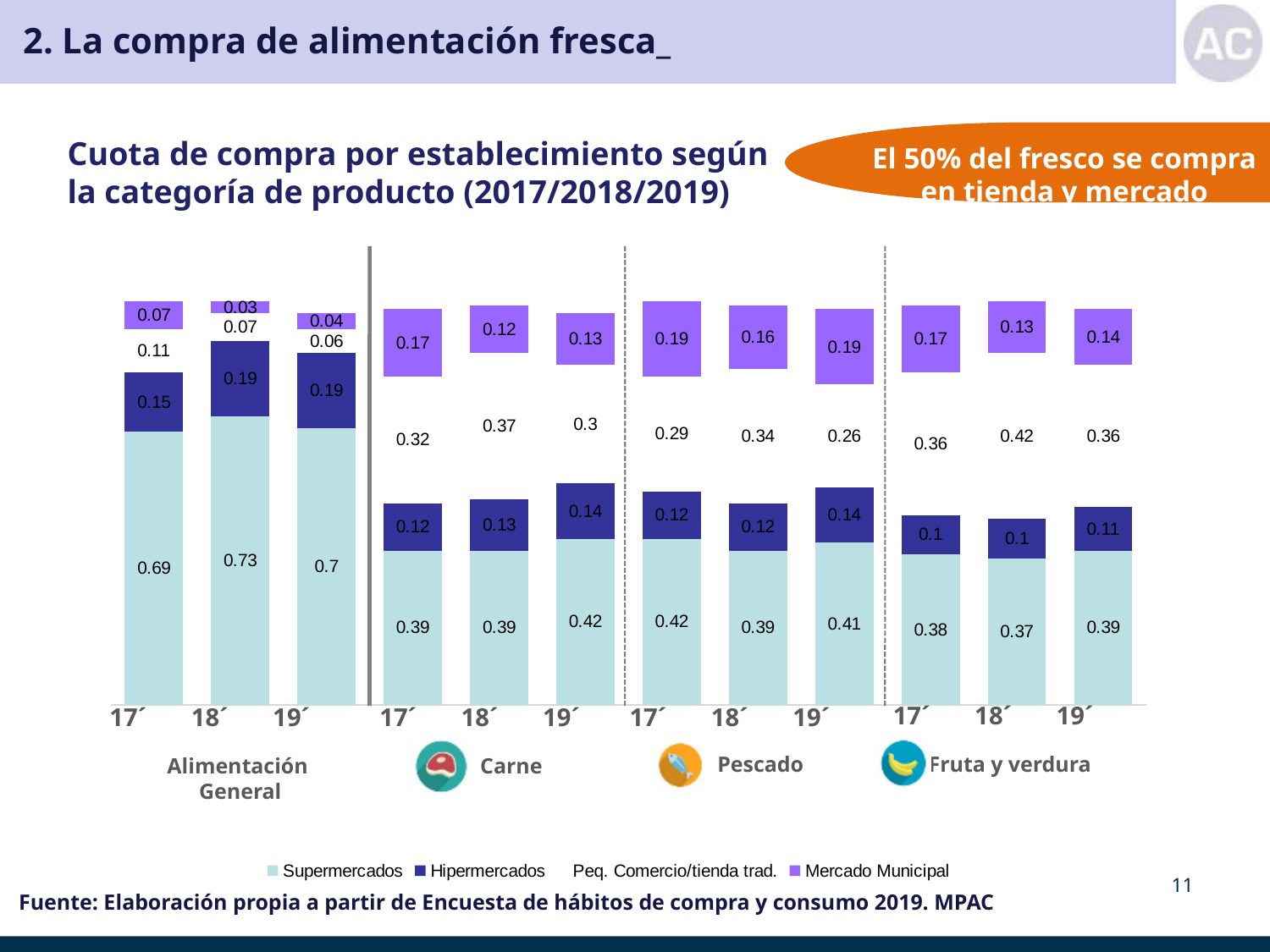
What is the difference between the Peq. Comercio/tienda trad. values for Fruta y verdura in 18´ and 19´? 0.06 How many product categories are shown along the x axis? 4 What is the Mercado Municipal value for Pescado in 19´? 0.19 What is the Supermercados value for Alimentación General in 18´? 0.73 Within the Carne group, which year has the highest Supermercados value? 19´ What is the Peq. Comercio/tienda trad. value for Carne in 18´? 0.37 What is the Hipermercados value for Fruta y verdura in 19´? 0.11 Which is larger: the Supermercados value for Pescado in 17´ or for Fruta y verdura in 17´? Pescado in 17´ How many series does the legend list? 4 Within the Alimentación General group, which year has the lowest Mercado Municipal value? 18´ What kind of chart is shown on the slide? Stacked bar chart What is the total of the stacked bar for Carne in 17´? 1